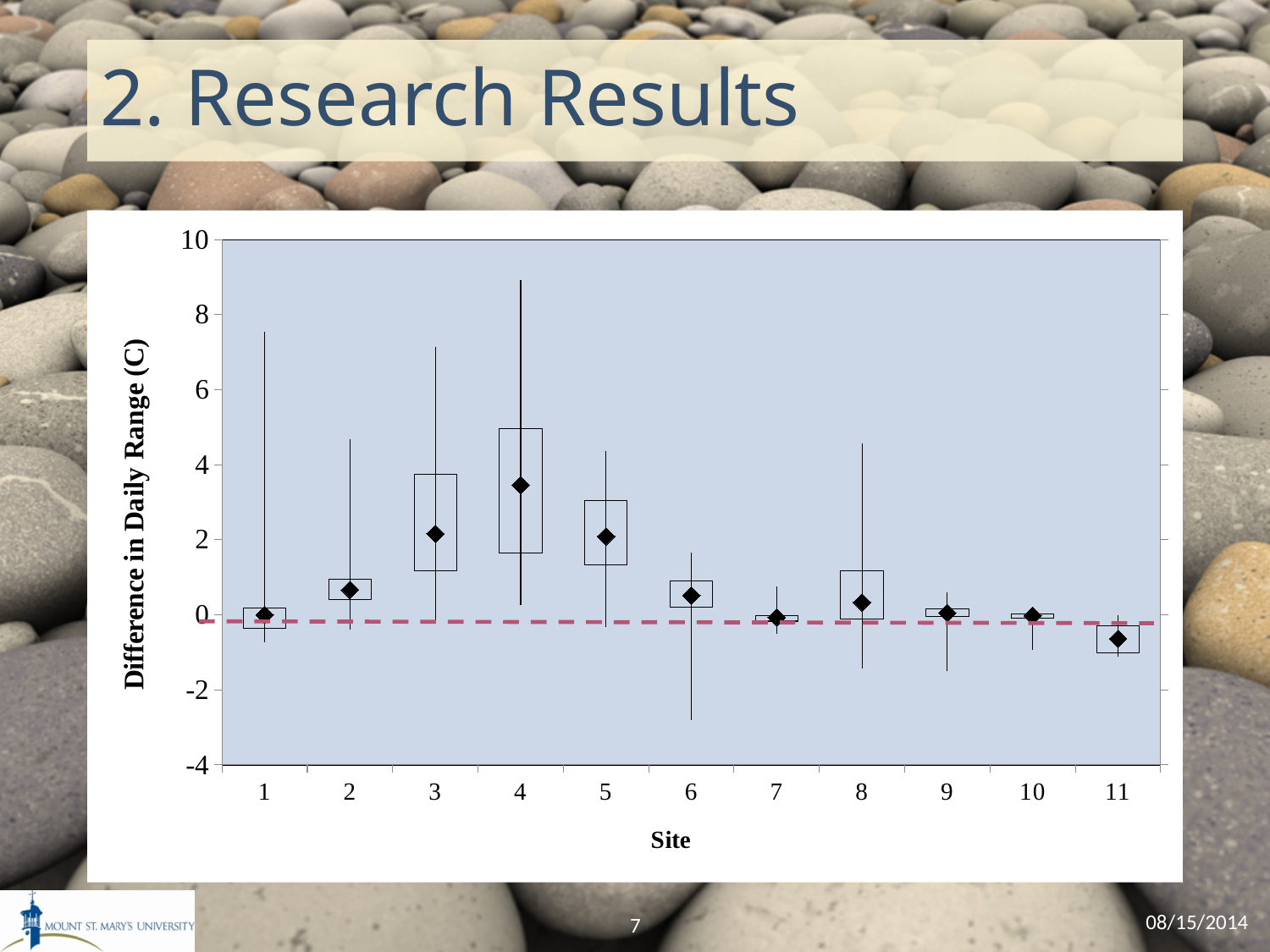
Is the diamond marker for Site 11 greater or less than 0? less Is the diamond marker for Site 6 greater or less than 2? less Do the diamond markers rise or fall from Site 4 to Site 7? fall Is the diamond marker for Site 4 greater or less than 2? greater How many sites are plotted along the x axis? 11 Which site has the larger diamond marker, Site 4 or Site 6? Site 4 Which site has the lowest diamond marker (mean difference in daily range)? Site 11 What is the title of the y axis? Difference in Daily Range (C) What kind of chart is shown on the slide? box plot Which site has the larger diamond marker, Site 5 or Site 9? Site 5 Which site has the highest diamond marker (mean difference in daily range)? Site 4